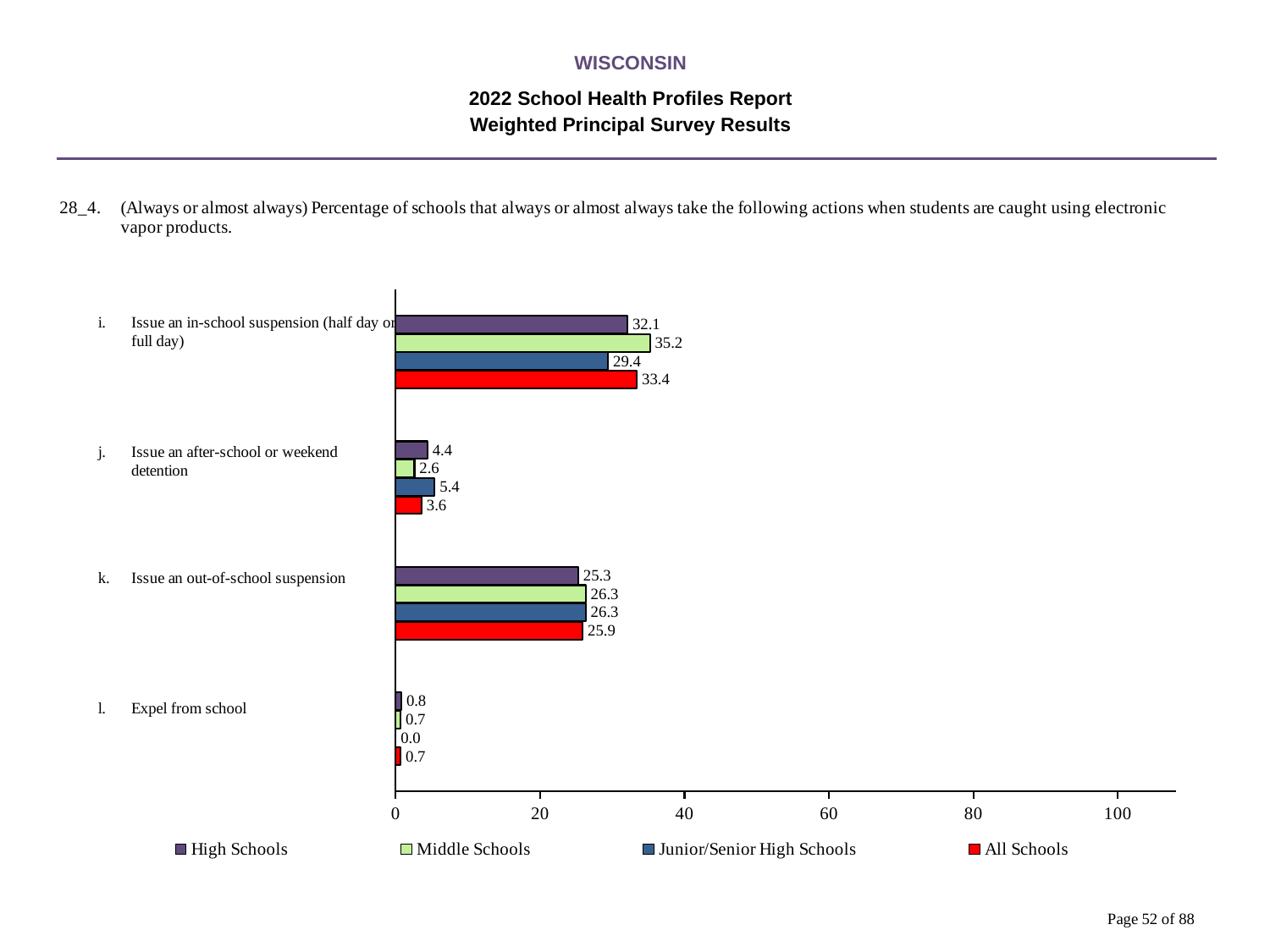
What is the value for Middle Schools for 'Issue an in-school suspension (half day or full day)'? 35.2 What is the value for All Schools for 'Issue an after-school or weekend detention'? 3.6 Is the All Schools value for 'Issue an in-school suspension (half day or full day)' greater or less than 40? less What is the value for Junior/Senior High Schools for 'Expel from school'? 0.0 What is the value for High Schools for 'Issue an out-of-school suspension'? 25.3 What is the difference between the Middle Schools and Junior/Senior High Schools values for 'Issue an in-school suspension (half day or full day)'? 5.8 Which school type has the highest value for 'Issue an in-school suspension (half day or full day)'? Middle Schools How many series does the legend list? 4 What kind of chart is shown on the slide? bar chart Which is larger for 'Issue an after-school or weekend detention': the High Schools value or the Junior/Senior High Schools value? Junior/Senior High Schools How many actions (categories) are shown on the chart? 4 Which school type has the lowest value for 'Issue an after-school or weekend detention'? Middle Schools